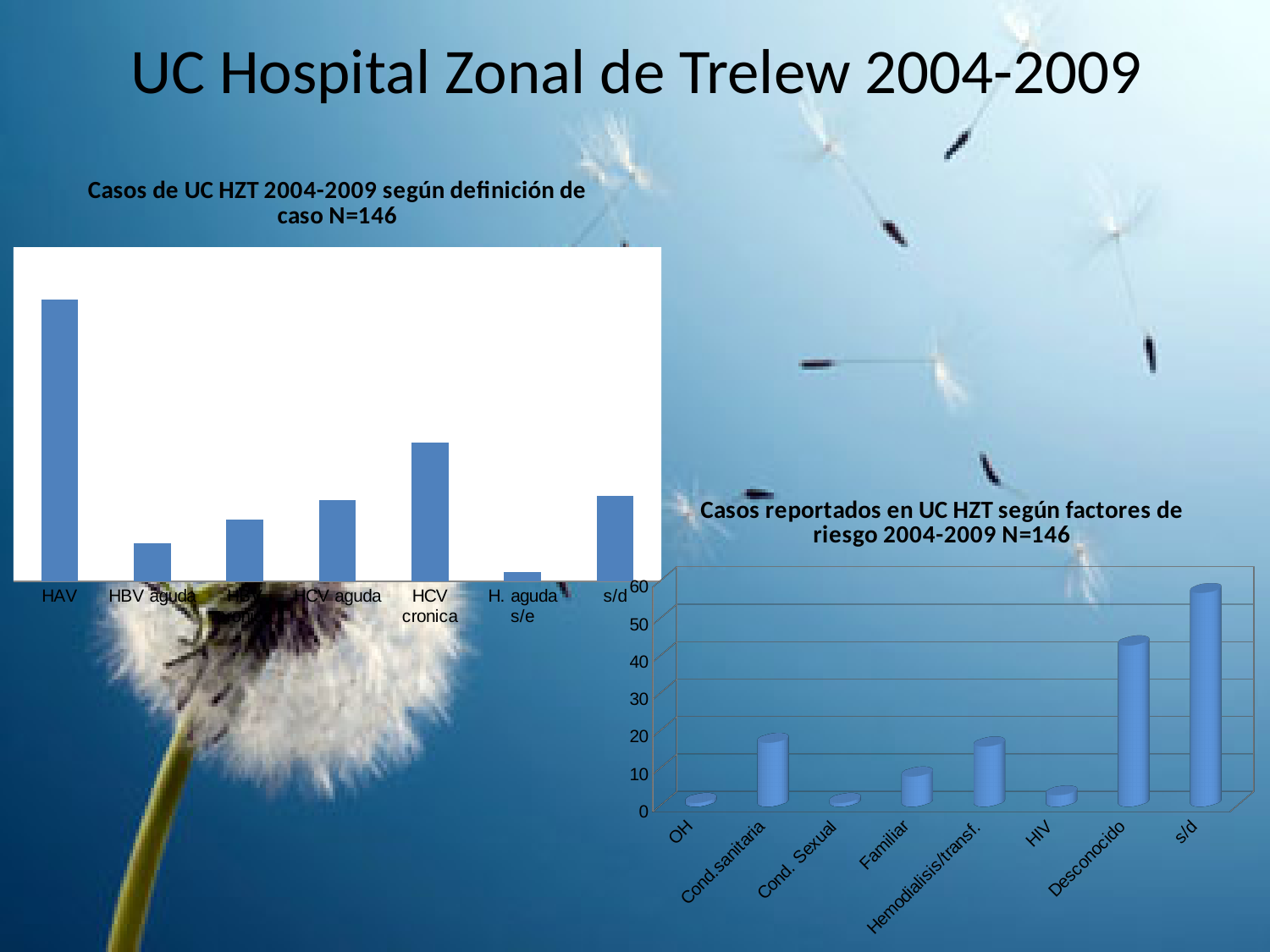
In the chart titled 'Casos reportados en UC HZT según factores de riesgo 2004-2009 N=146', is the value for Desconocido greater or less than 30? greater In the chart titled 'Casos de UC HZT 2004-2009 según definición de caso N=146', how many categories are shown on the x axis? 7 In the chart titled 'Casos de UC HZT 2004-2009 según definición de caso N=146', which category has the highest bar? HAV In the chart titled 'Casos de UC HZT 2004-2009 según definición de caso N=146', which is larger, HCV cronica or HCV aguda? HCV cronica In the chart titled 'Casos de UC HZT 2004-2009 según definición de caso N=146', which category has the lowest bar? H. aguda s/e What kind of chart is the one titled 'Casos de UC HZT 2004-2009 según definición de caso N=146'? Bar chart In the chart titled 'Casos reportados en UC HZT según factores de riesgo 2004-2009 N=146', how many categories are shown on the x axis? 8 In the chart titled 'Casos reportados en UC HZT según factores de riesgo 2004-2009 N=146', is the value for Cond.sanitaria greater or less than 20? less In the chart titled 'Casos reportados en UC HZT según factores de riesgo 2004-2009 N=146', which is larger, Desconocido or Cond.sanitaria? Desconocido In the chart titled 'Casos reportados en UC HZT según factores de riesgo 2004-2009 N=146', is the value for s/d greater or less than 50? greater In the chart titled 'Casos reportados en UC HZT según factores de riesgo 2004-2009 N=146', which category has the highest value? s/d